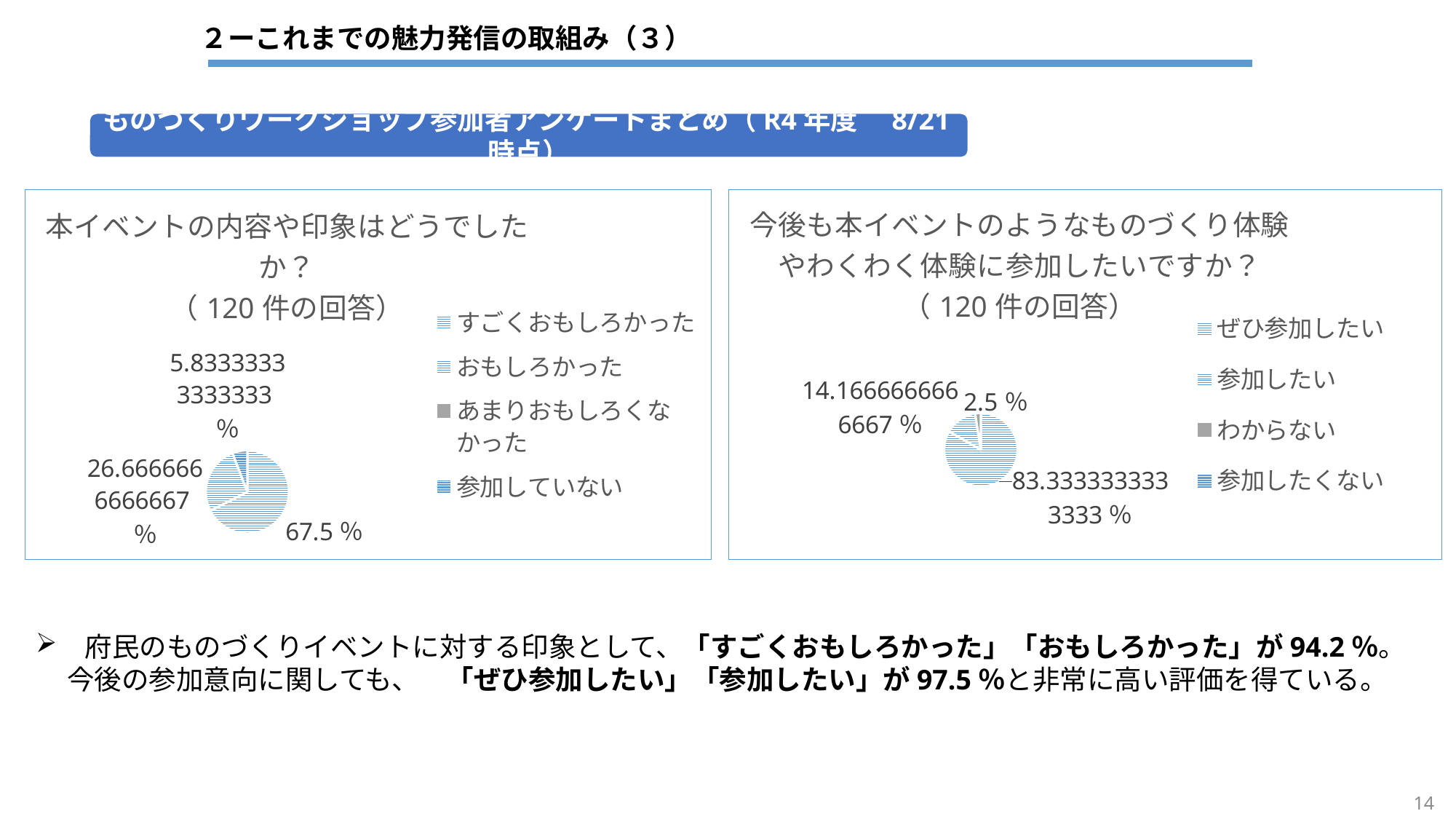
What kind of chart is shown in the left panel (本イベントの内容や印象はどうでしたか？)? pie chart In the right pie chart (今後も本イベントのようなものづくり体験やわくわく体験に参加したいですか？), what is the largest percentage label shown? 83.3333333333333 % What kind of chart is shown in the right panel (今後も本イベントのようなものづくり体験やわくわく体験に参加したいですか？)? pie chart In the left pie chart (本イベントの内容や印象はどうでしたか？), how many entries does the legend list? 4 In the right pie chart (今後も本イベントのようなものづくり体験やわくわく体験に参加したいですか？), which is larger: the slice labelled 14.1666666666667 % or the slice labelled 2.5 %? 14.1666666666667 % In the left pie chart (本イベントの内容や印象はどうでしたか？), what share is labelled for すごくおもしろかった? 67.5 % In the right pie chart (今後も本イベントのようなものづくり体験やわくわく体験に参加したいですか？), how many entries does the legend list? 4 In the right pie chart (今後も本イベントのようなものづくり体験やわくわく体験に参加したいですか？), what is the smallest percentage label shown? 2.5 % In the left pie chart (本イベントの内容や印象はどうでしたか？), what is the largest percentage label shown? 67.5 % How many responses does the title of the left pie chart (本イベントの内容や印象はどうでしたか？) say were collected? 120 件 In the left pie chart (本イベントの内容や印象はどうでしたか？), what is the smallest percentage label shown? 5.83333333333333 % In the right pie chart (今後も本イベントのようなものづくり体験やわくわく体験に参加したいですか？), what share is labelled for ぜひ参加したい? 83.3333333333333 %